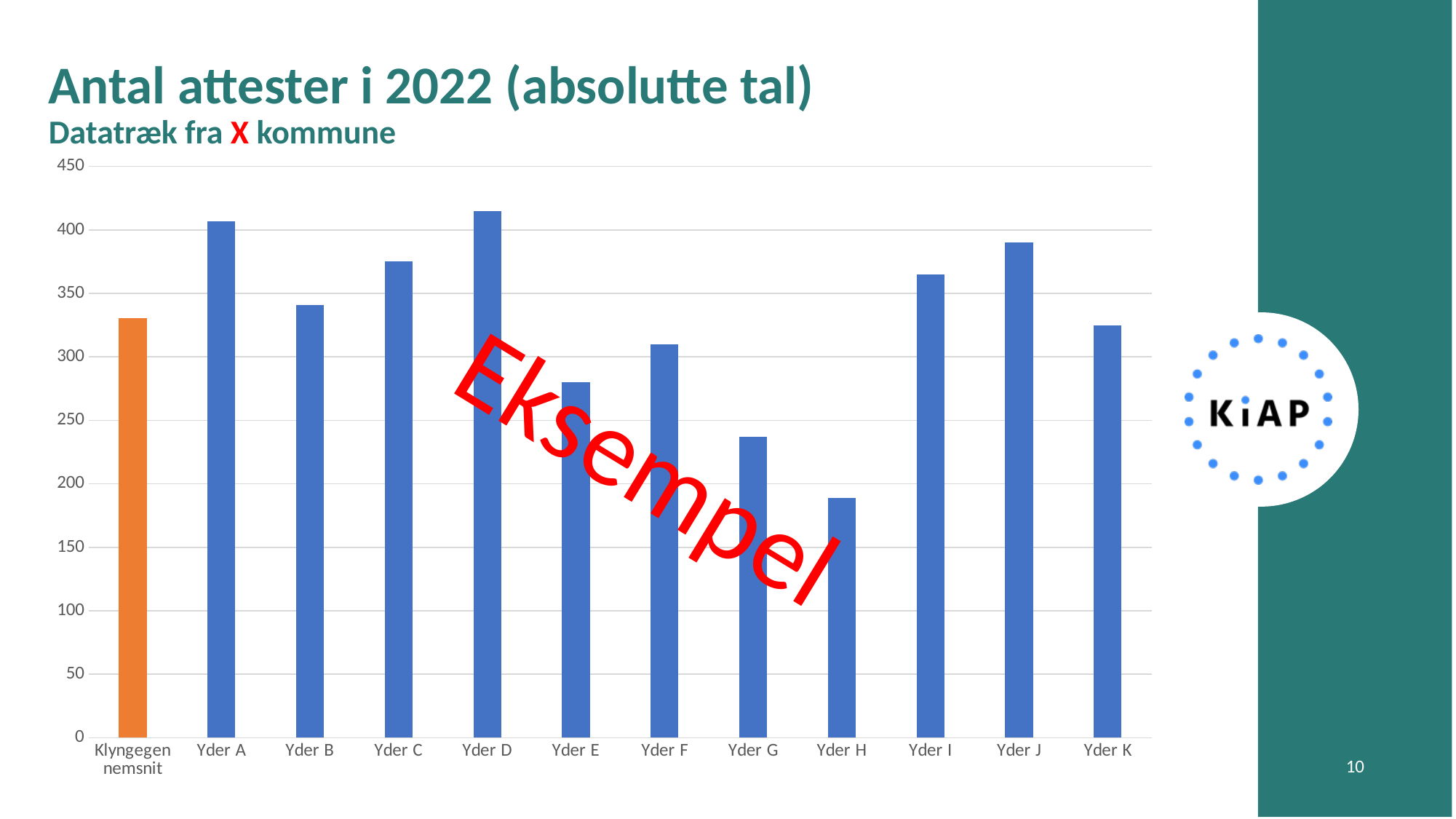
Is the value for Yder D greater or less than 400? greater Which category has the lowest value in the chart? Yder H Is the value for Yder G greater or less than 250? less How many bars (categories) are plotted in the chart? 12 What is the title of the chart on the slide? Antal attester i 2022 (absolutte tal) Which is larger, the value for Yder A or the value for Yder B? Yder A Which bar is coloured orange instead of blue? Klyngegennemsnit Which is larger, the value for Yder G or the value for Yder E? Yder E What kind of chart is shown on the slide? Bar chart Is the value for Yder J greater or less than 350? greater Which category has the highest value in the chart? Yder D